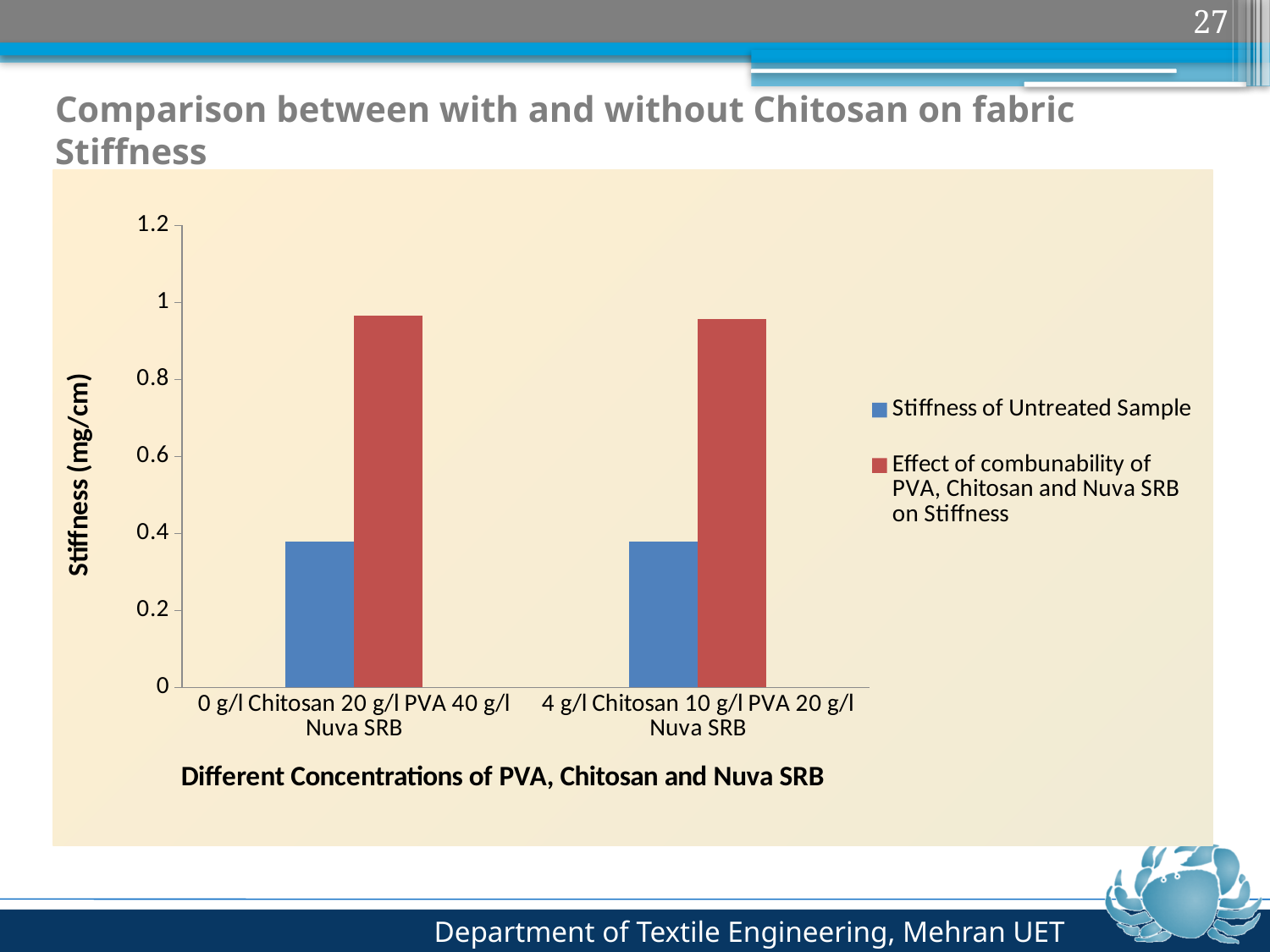
Is the value for Stiffness of Untreated Sample at 4 g/l Chitosan 10 g/l PVA 20 g/l Nuva SRB greater or less than 0.2? greater What kind of chart is shown on the slide? bar chart Is the value for Effect of combunability of PVA, Chitosan and Nuva SRB on Stiffness at 0 g/l Chitosan 20 g/l PVA 40 g/l Nuva SRB greater or less than 0.8? greater How many categories are shown on the x axis of the chart? 2 At 4 g/l Chitosan 10 g/l PVA 20 g/l Nuva SRB, which series has the smaller value: Stiffness of Untreated Sample or Effect of combunability of PVA, Chitosan and Nuva SRB on Stiffness? Stiffness of Untreated Sample Which colour represents Stiffness of Untreated Sample in the chart's legend? blue Is the value for Stiffness of Untreated Sample at 0 g/l Chitosan 20 g/l PVA 40 g/l Nuva SRB greater or less than 0.4? less How many series does the chart's legend list? 2 What is the title of the chart's vertical axis? Stiffness (mg/cm) At 0 g/l Chitosan 20 g/l PVA 40 g/l Nuva SRB, which series has the larger value: Stiffness of Untreated Sample or Effect of combunability of PVA, Chitosan and Nuva SRB on Stiffness? Effect of combunability of PVA, Chitosan and Nuva SRB on Stiffness